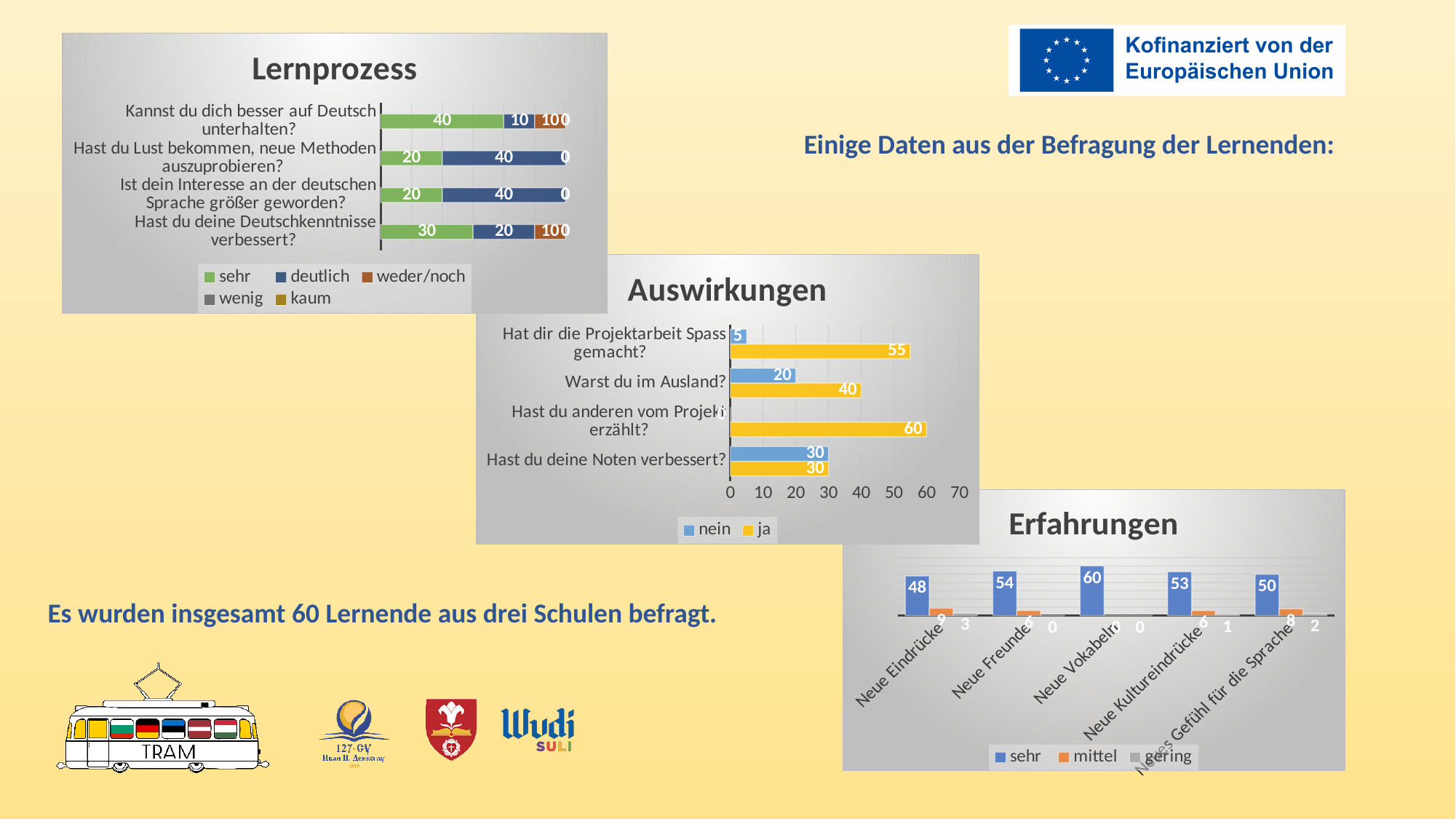
In the "Erfahrungen" chart, what is the "sehr" value for "Neue Vokabeln"? 60 In the "Lernprozess" chart, what is the "sehr" value for "Kannst du dich besser auf Deutsch unterhalten?"? 40 In the "Erfahrungen" chart, which category has the lowest "sehr" value? Neue Eindrücke How many categories are shown in the "Erfahrungen" chart? 5 What kind of chart is the "Erfahrungen" chart? Bar chart In the "Auswirkungen" chart, what is the difference between the "ja" and "nein" values for "Hat dir die Projektarbeit Spass gemacht?"? 50 How many series does the legend of the "Lernprozess" chart list? 5 In the "Auswirkungen" chart, which question has the highest "ja" value? Hast du anderen vom Projekt erzählt? In the "Auswirkungen" chart, what is the "nein" value for "Warst du im Ausland?"? 20 In the "Auswirkungen" chart, what is the "ja" value for "Hast du anderen vom Projekt erzählt?"? 60 In the "Erfahrungen" chart, is the "sehr" value for "Neue Freunde" larger than the "sehr" value for "Neues Gefühl für die Sprache"? Yes How many series does the legend of the "Auswirkungen" chart list? 2